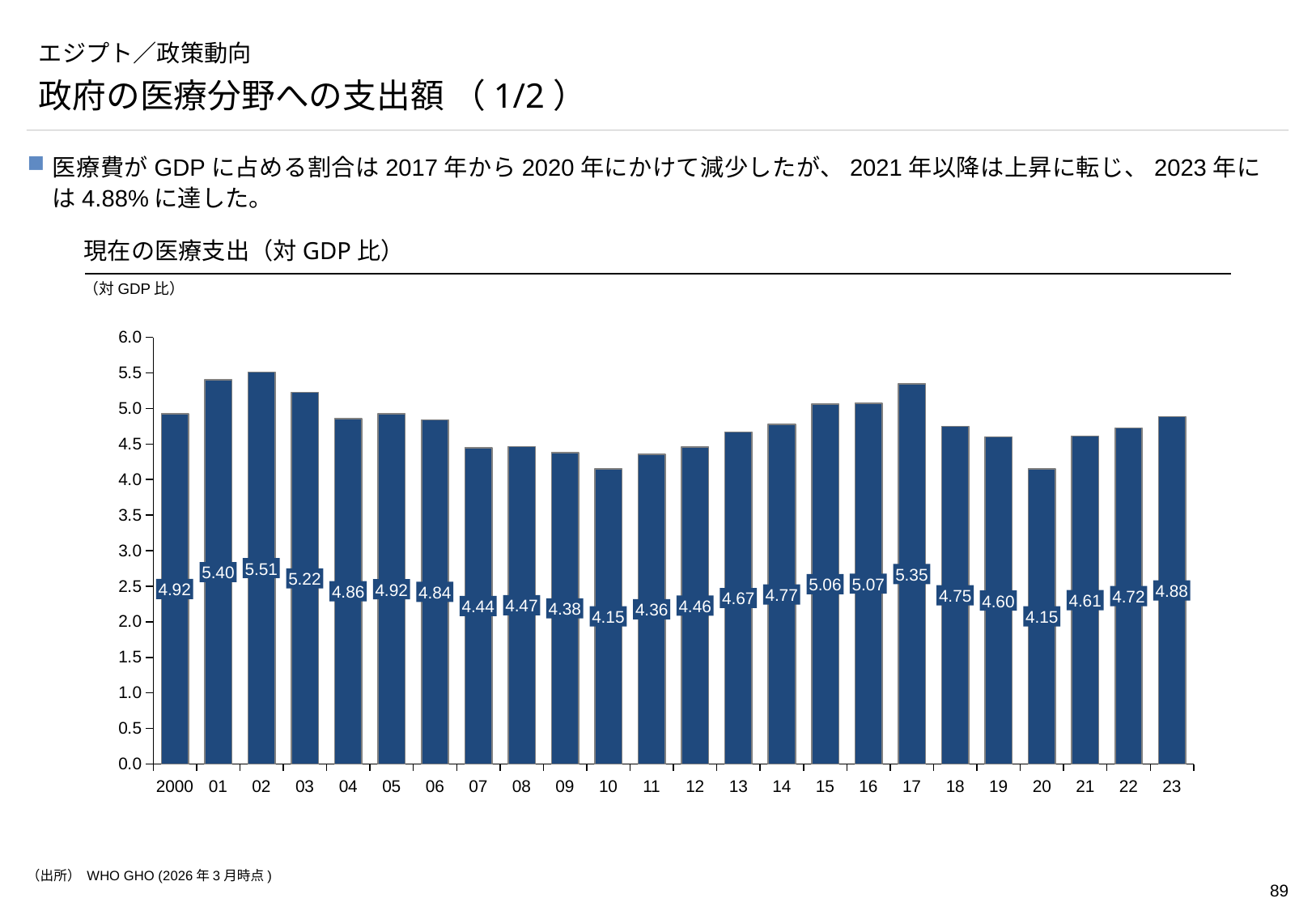
What is the lowest value shown in the chart? 4.15 Is the value for 2016 greater or less than 5.0? greater How many years are shown in the chart? 24 What is the value for 2017 in the chart? 5.35 What is the value for 2023 in the chart? 4.88 What is the value for 2010 in the chart? 4.15 What is the difference between the values for 2002 and 2003? 0.29 Which is larger, the value for 2001 or the value for 2017? 2001 What kind of chart is shown on the slide? bar chart Which year has the highest value in the chart? 2002 Do the values rise or fall from 2017 to 2020? fall What is the difference between the values for 2023 and 2020? 0.73